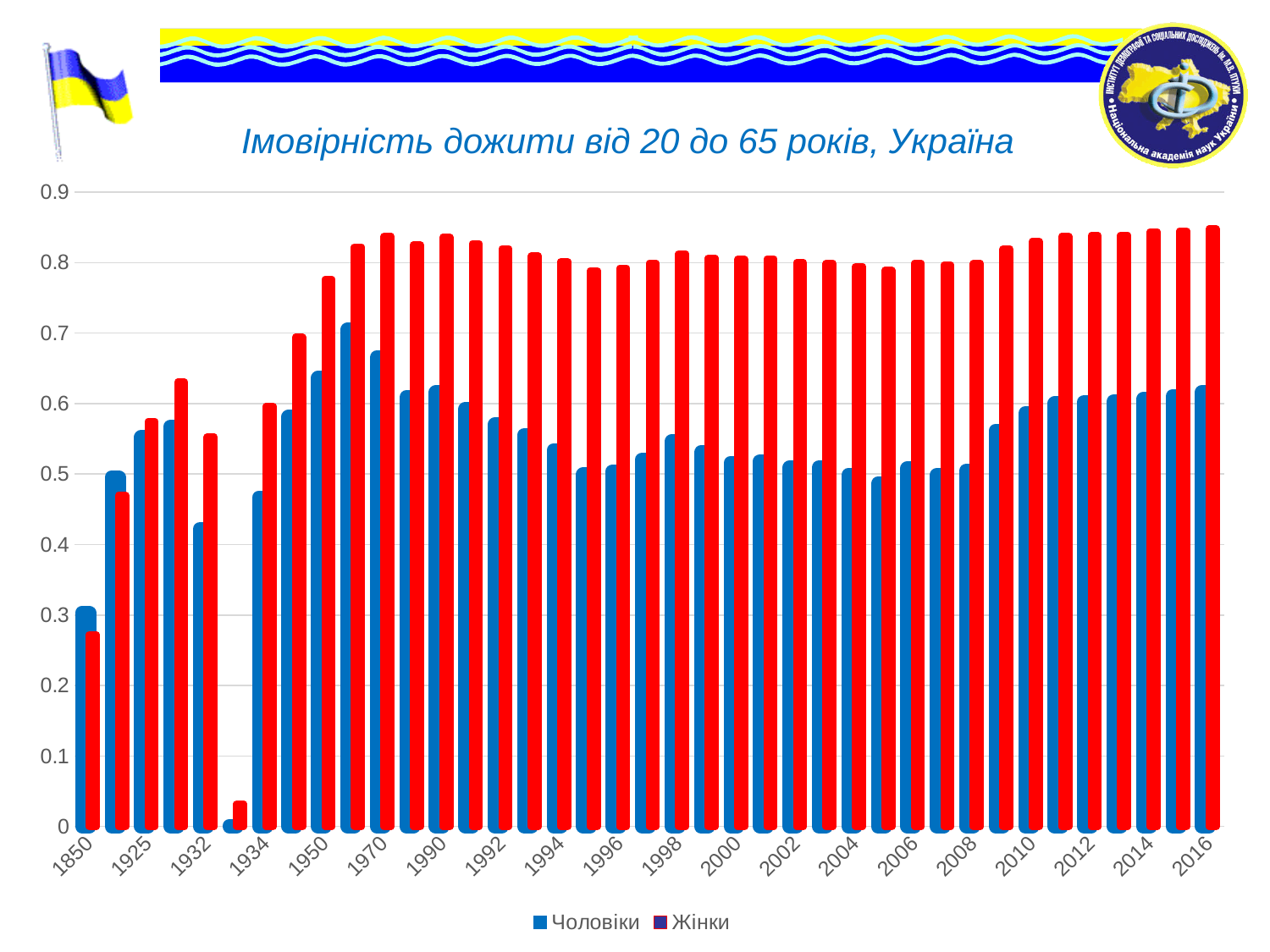
How many series does the legend list? 2 Is the value for Жінки in 1850 greater or less than 0.3? less Which colour represents the Жінки series? red In 2016, which series has the larger value, Чоловіки or Жінки? Жінки Is the value for Жінки in 2016 greater or less than 0.8? greater What is the title of the chart? Імовірність дожити від 20 до 65 років, Україна What kind of chart is shown on the slide? bar chart Do the values for Жінки rise or fall from 2008 to 2016? rise In 1850, which series has the larger value, Чоловіки or Жінки? Чоловіки Is the value for Жінки in 1950 greater or less than 0.7? greater